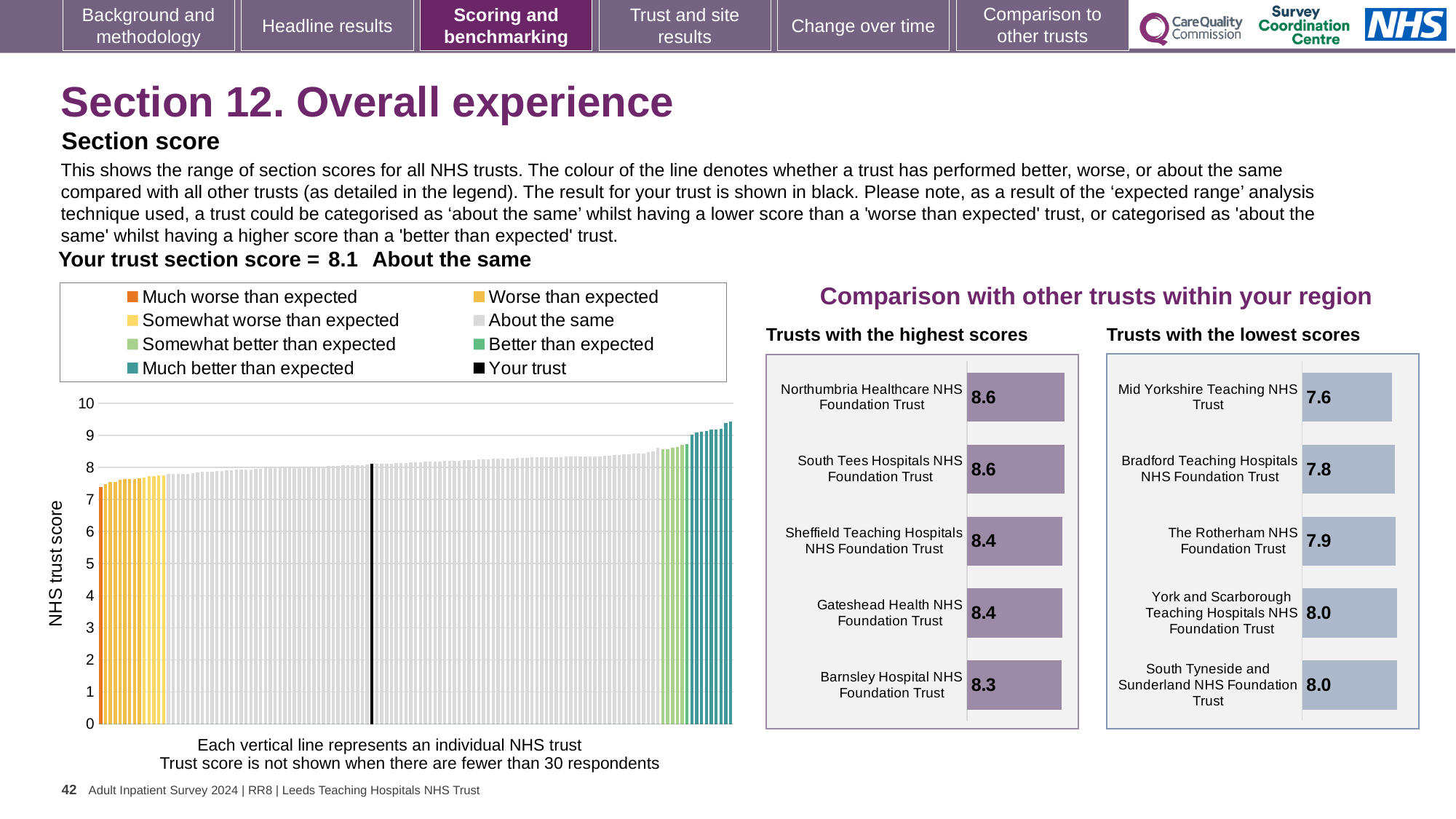
In the 'Trusts with the lowest scores' chart, what is the difference between the scores of South Tyneside and Sunderland NHS Foundation Trust and Mid Yorkshire Teaching NHS Trust? 0.4 In the 'Trusts with the lowest scores' chart, which trust has the lowest score? Mid Yorkshire Teaching NHS Trust In the 'Trusts with the lowest scores' chart, what is the score for Bradford Teaching Hospitals NHS Foundation Trust? 7.8 How many entries does the legend of the left-hand NHS trust score chart list? 8 In the 'Trusts with the lowest scores' chart, which has the larger score: Bradford Teaching Hospitals NHS Foundation Trust or The Rotherham NHS Foundation Trust? The Rotherham NHS Foundation Trust In the 'Trusts with the highest scores' chart, what is the score for Sheffield Teaching Hospitals NHS Foundation Trust? 8.4 In the left-hand NHS trust score chart, is the value of the leftmost bar greater or less than 8? less How many trusts are listed in the 'Trusts with the lowest scores' chart? 5 What kind of chart is the large chart on the left showing NHS trust scores? Bar chart In the 'Trusts with the highest scores' chart, what is the difference between the scores of Northumbria Healthcare NHS Foundation Trust and Barnsley Hospital NHS Foundation Trust? 0.3 In the 'Trusts with the highest scores' chart, which trust has the lowest score? Barnsley Hospital NHS Foundation Trust In the left-hand NHS trust score chart, do the bar values rise or fall from left to right? Rise